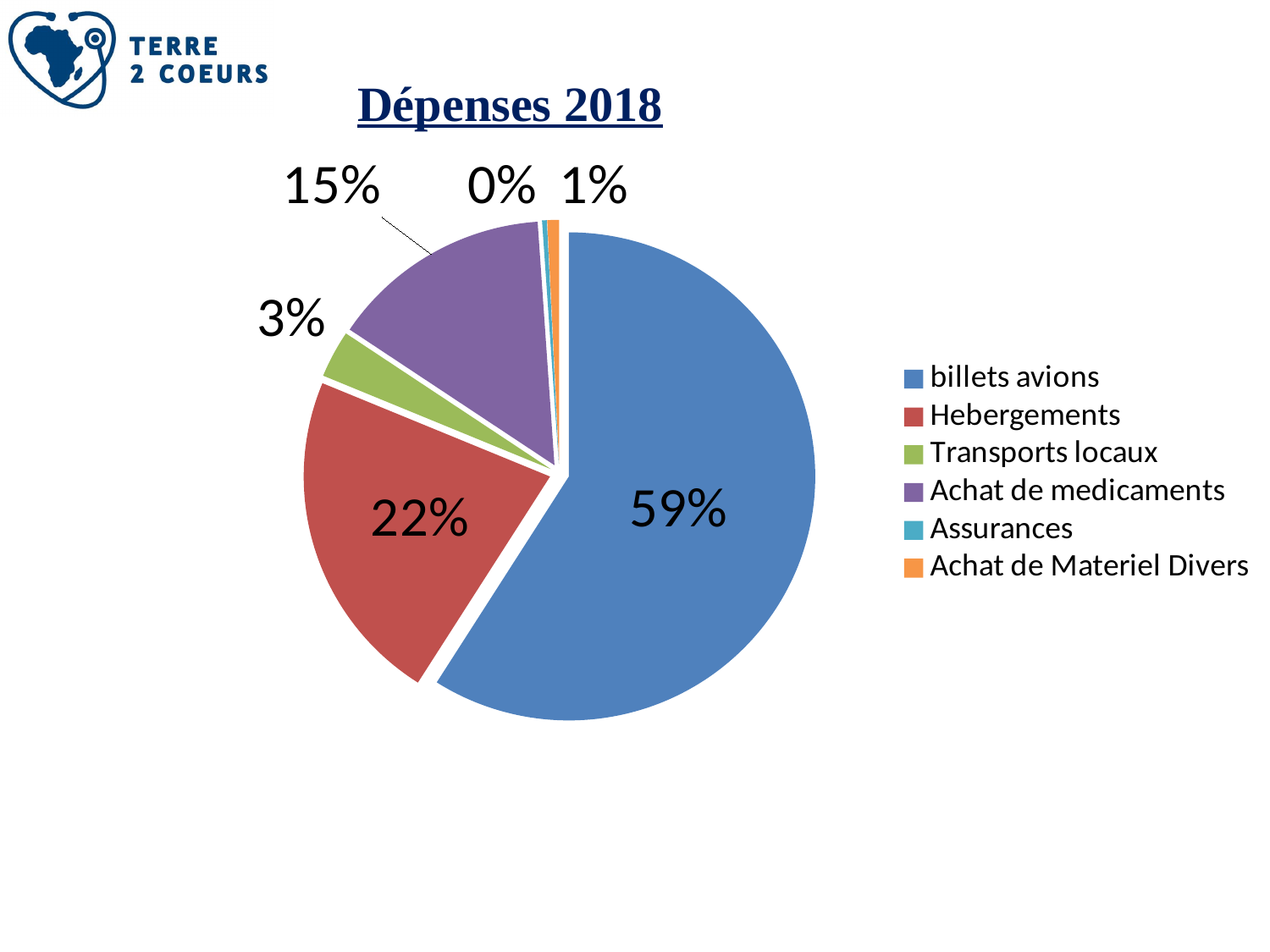
What is the difference in percentage points between billets avions and Hebergements? 37 What type of chart is shown on the slide? pie chart How many categories does the legend list? 6 Which is larger, the share for Achat de medicaments or the share for Transports locaux? Achat de medicaments What share of the pie does Assurances represent? 0% What share of the pie does Achat de Materiel Divers represent? 1% What share of the pie does Hebergements represent? 22% Which category has the smallest share of the pie? Assurances Which category has the largest share of the pie? billets avions